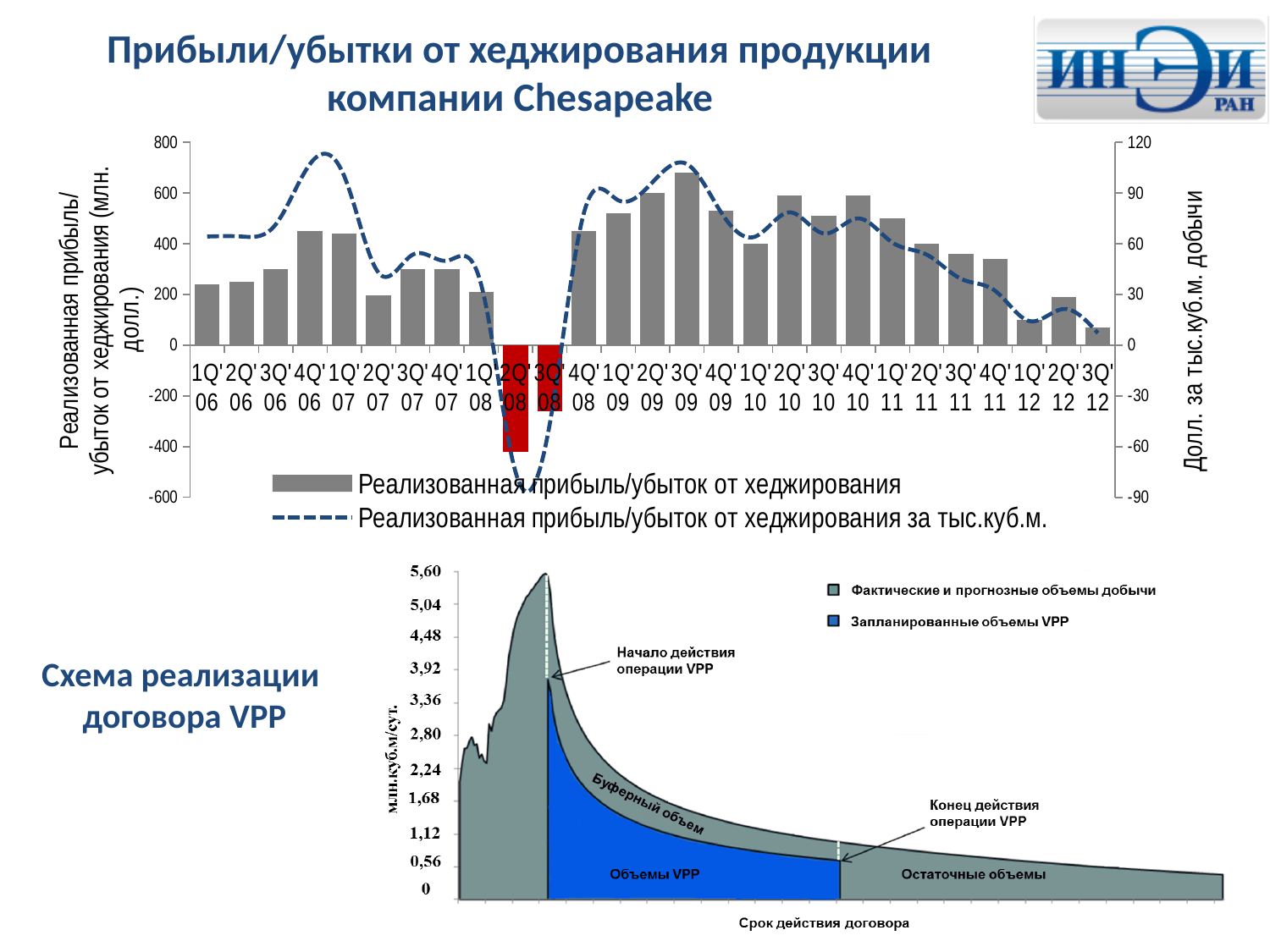
On the top chart, is the bar value for 3Q'09 greater or less than 600? greater On the top chart, is the bar value for 2Q'08 greater or less than -200? less On the top chart, how many quarters are shown on the x axis? 27 On the top chart (Прибыли/убытки от хеджирования продукции компании Chesapeake), what kind of chart is used for the series 'Реализованная прибыль/убыток от хеджирования'? bar chart On the top chart, how many series does the legend list? 2 On the top chart, how many bars are shown in red (negative values)? 2 On the top chart, what is the label of the right-hand y axis? Долл. за тыс.куб.м. добычи On the top chart, which quarter has the highest bar for realized hedging profit/loss? 3Q'09 On the bottom chart (Схема реализации договора VPP), what is the label of the x axis? Срок действия договора On the top chart, which bar is larger: 3Q'09 or 1Q'10? 3Q'09 On the top chart, which quarter has the lowest bar for realized hedging profit/loss? 2Q'08 On the top chart, is the bar value for 1Q'06 greater or less than 400? less